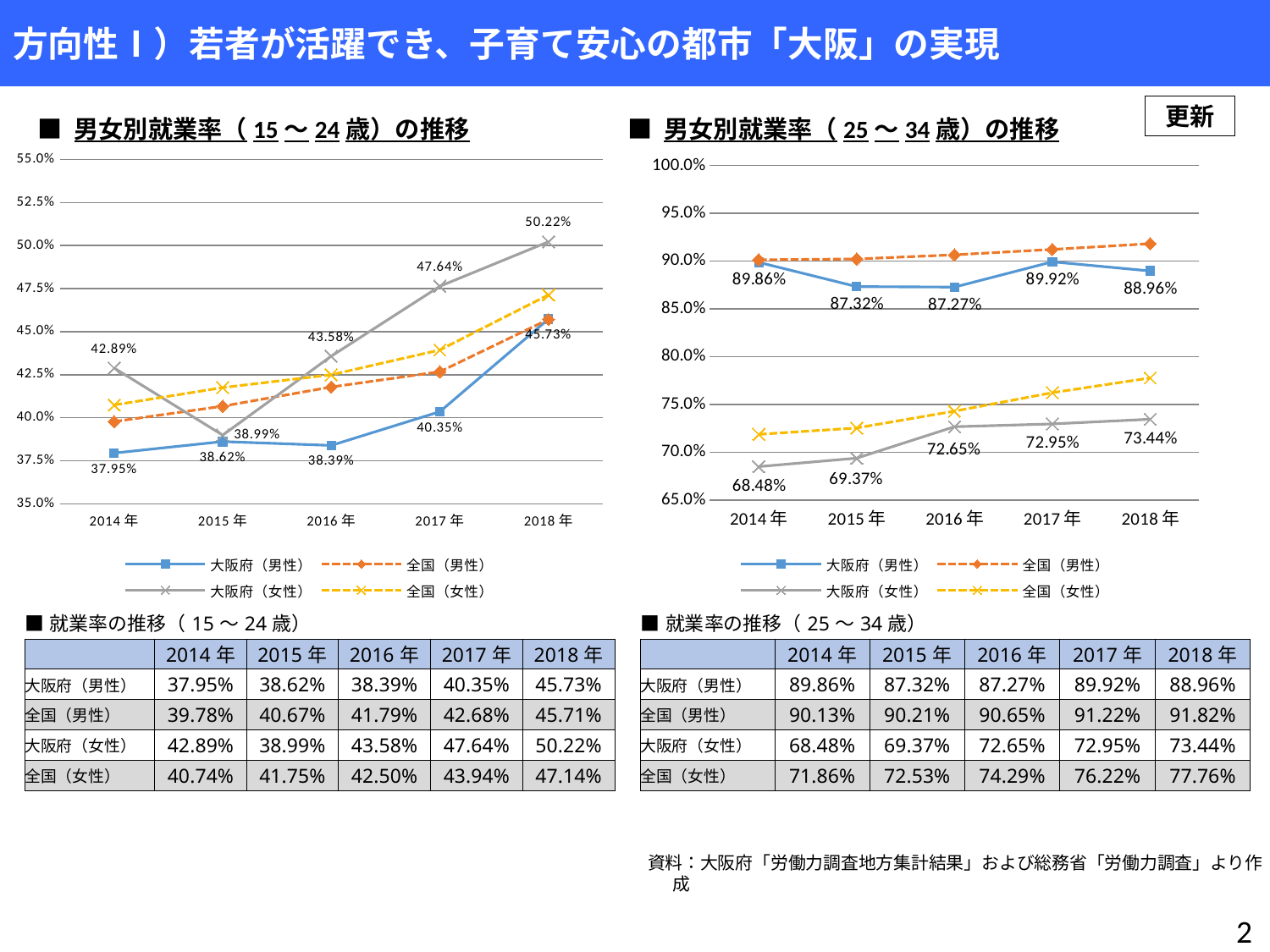
In the right chart (男女別就業率（25～34歳）の推移), what is the value for 大阪府（女性） in 2014年? 68.48% In the right chart (25～34歳), is the value for 全国（男性） in 2018年 greater or less than 90.0%? greater In the right chart (25～34歳), which is larger in 2018年: 全国（女性） or 大阪府（女性）? 全国（女性） How many years are plotted on the x axis of the left chart (15～24歳)? 5 How many series does the legend of the right chart (25～34歳) list? 4 What kind of chart is the left chart (男女別就業率（15～24歳）の推移)? Line chart In the left chart (15～24歳), in which year is the value for 大阪府（女性） highest? 2018年 What is the title of the right chart? 男女別就業率（25～34歳）の推移 In the left chart (15～24歳), what is the difference between the 2018年 and 2014年 values for 大阪府（女性）? 7.33 percentage points In the right chart (25～34歳), does the value for 全国（男性） rise or fall from 2014年 to 2018年? Rises In the left chart (15～24歳), in which year is the value for 大阪府（女性） lowest? 2015年 In the left chart (男女別就業率（15～24歳）の推移), what is the value for 大阪府（男性） in 2018年? 45.73%